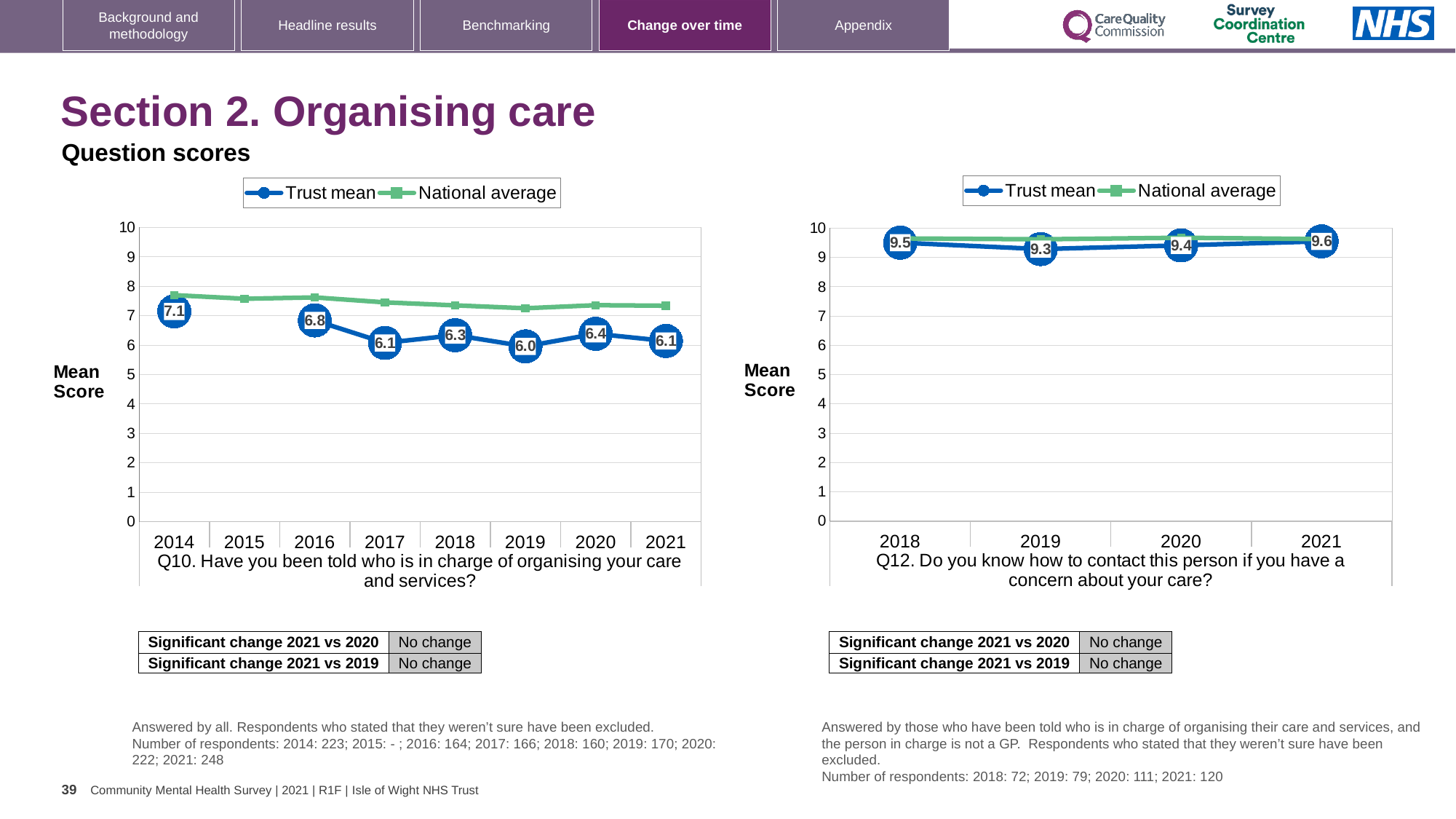
In the Q10 chart on the left, what is the difference between the Trust mean scores for 2014 and 2021? 1.0 In the Q10 chart on the left, what is the Trust mean score for 2021? 6.1 In the Q10 chart on the left, what is the Trust mean score for 2014? 7.1 In the Q12 chart on the right, which year has the highest Trust mean score? 2021 In the Q10 chart on the left, is the National average for 2014 greater or less than 7? greater In the Q12 chart on the right, how many years are shown on the x axis? 4 How many series does the legend of the Q10 chart on the left list? 2 In the Q12 chart on the right, what is the Trust mean score for 2019? 9.3 In the Q12 chart on the right, is the Trust mean score for 2021 larger than the Trust mean score for 2019? Yes In the Q10 chart on the left, which year has the lowest Trust mean score? 2019 In the Q10 chart on the left, which year has the highest Trust mean score? 2014 What type of chart is the Q12 chart on the right? Line chart